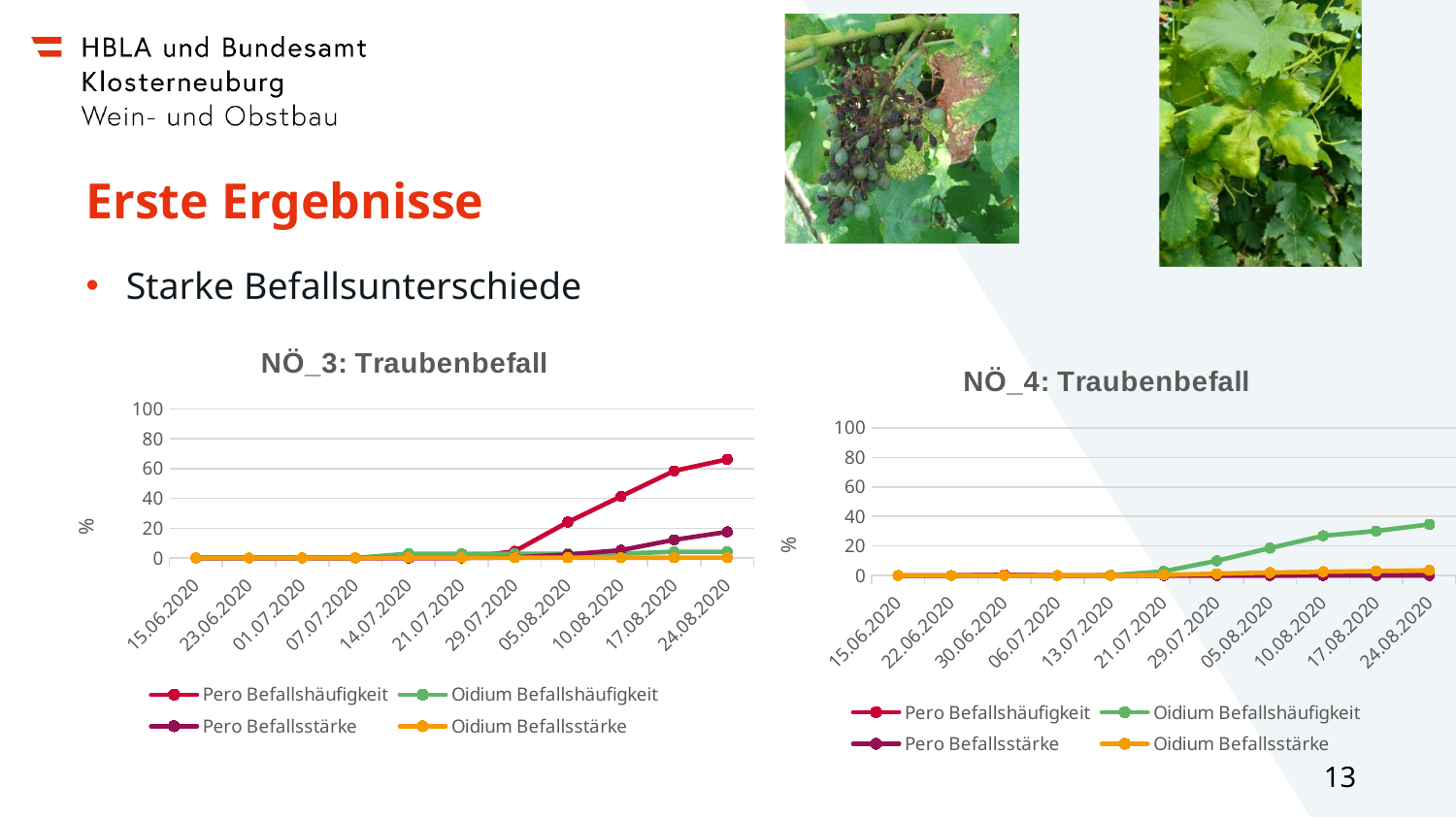
What is the first date shown on the x axis of the NÖ_4: Traubenbefall chart? 15.06.2020 In the NÖ_4: Traubenbefall chart, is the value of Oidium Befallshäufigkeit on 24.08.2020 greater or less than 40? less In the NÖ_4: Traubenbefall chart, does Oidium Befallshäufigkeit rise or fall from 21.07.2020 to 24.08.2020? rise In the NÖ_3: Traubenbefall chart, is the value of Pero Befallshäufigkeit on 24.08.2020 greater or less than 60? greater How many series does the legend of the NÖ_4: Traubenbefall chart list? 4 What kind of chart is the NÖ_3: Traubenbefall chart? line chart In the NÖ_3: Traubenbefall chart, which series has the highest value on 24.08.2020? Pero Befallshäufigkeit What is the label of the y axis on the NÖ_3: Traubenbefall chart? % In the NÖ_3: Traubenbefall chart, does Pero Befallshäufigkeit rise or fall from 29.07.2020 to 24.08.2020? rise In the NÖ_4: Traubenbefall chart, which series has the highest value on 24.08.2020? Oidium Befallshäufigkeit In the NÖ_3: Traubenbefall chart, which is larger on 24.08.2020: Pero Befallshäufigkeit or Pero Befallsstärke? Pero Befallshäufigkeit How many dates are shown on the x axis of the NÖ_3: Traubenbefall chart? 11